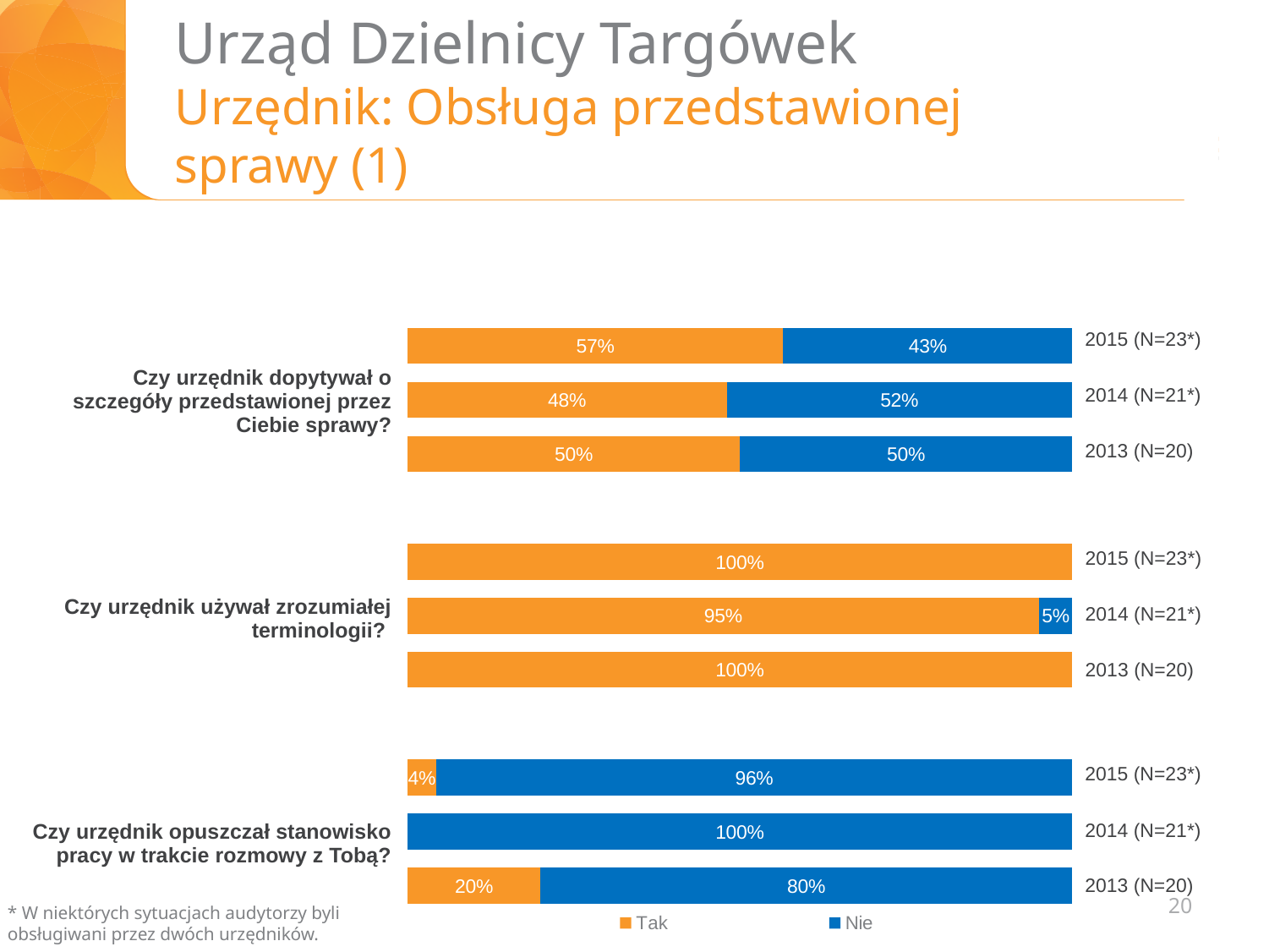
How many years are shown for each question in the chart? 3 What are the two series named in the legend? Tak and Nie For "Czy urzędnik dopytywał o szczegóły przedstawionej przez Ciebie sprawy?", which year has the highest "Tak" share? 2015 (N=23*) How many series does the legend list? 2 What percentage answered "Nie" in 2014 (N=21*) to "Czy urzędnik używał zrozumiałej terminologii?"? 5% For "Czy urzędnik opuszczał stanowisko pracy w trakcie rozmowy z Tobą?", is the "Nie" share larger in 2015 (N=23*) or in 2013 (N=20)? 2015 (N=23*) What is the difference between the "Tak" share in 2015 (N=23*) and in 2014 (N=21*) for "Czy urzędnik dopytywał o szczegóły przedstawionej przez Ciebie sprawy?"? 9 percentage points What percentage answered "Tak" in 2013 (N=20) to "Czy urzędnik opuszczał stanowisko pracy w trakcie rozmowy z Tobą?"? 20% What kind of chart is shown on the slide? stacked bar chart What percentage answered "Nie" in 2014 (N=21*) to "Czy urzędnik dopytywał o szczegóły przedstawionej przez Ciebie sprawy?"? 52% What percentage answered "Tak" in 2015 (N=23*) to "Czy urzędnik dopytywał o szczegóły przedstawionej przez Ciebie sprawy?"? 57% For "Czy urzędnik opuszczał stanowisko pracy w trakcie rozmowy z Tobą?", which year has the lowest "Nie" share? 2013 (N=20)